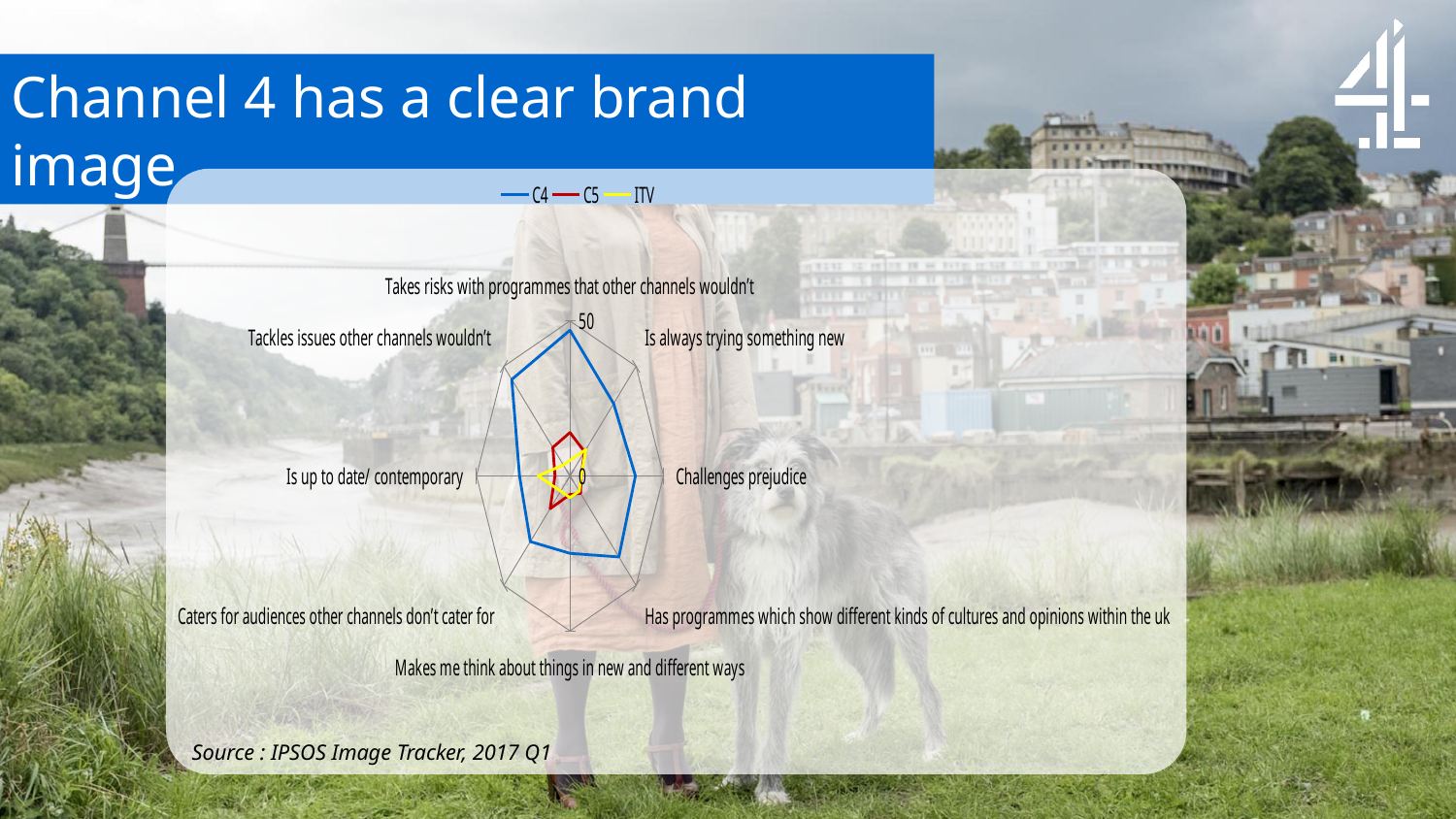
Which series is drawn in blue on the chart? C4 Which is larger for 'Challenges prejudice': C4 or ITV? C4 What is the maximum value shown on the chart's axis scale? 50 Which is larger for 'Takes risks with programmes that other channels wouldn't': C4 or C5? C4 What kind of chart is shown on the slide? Radar chart Which series are listed in the chart's legend? C4, C5, ITV Which series has the largest values across the chart? C4 How many series does the chart's legend list? 3 How many categories (axes) does the radar chart have? 8 Is the value for ITV on 'Is always trying something new' greater or less than 50? less Is the value for C5 on 'Takes risks with programmes that other channels wouldn't' greater or less than 50? less